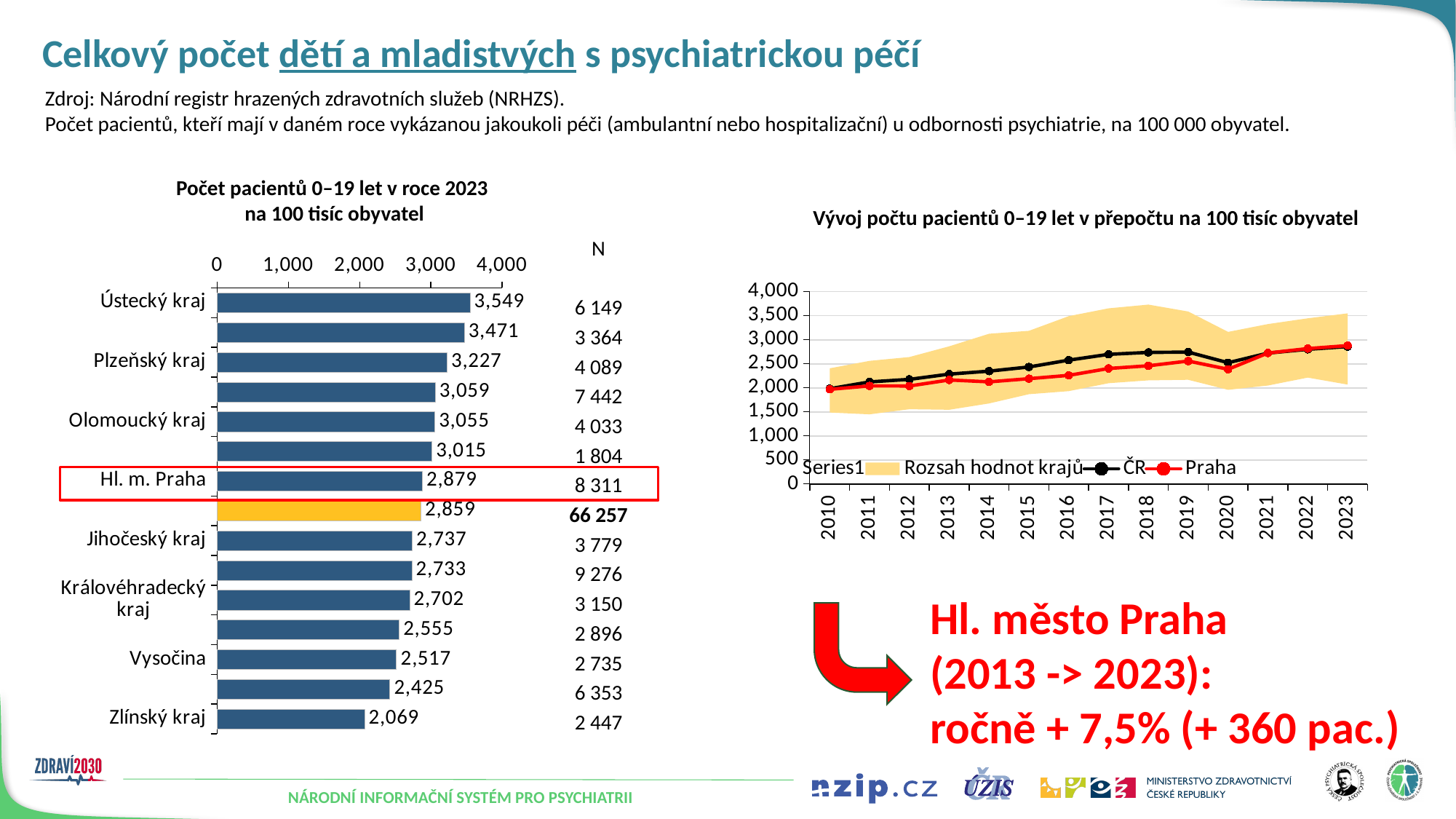
In the bar chart 'Počet pacientů 0–19 let v roce 2023 na 100 tisíc obyvatel', which region has the lowest value? Zlínský kraj In the line chart 'Vývoj počtu pacientů 0–19 let v přepočtu na 100 tisíc obyvatel', how many entries does the legend list? 4 In the bar chart 'Počet pacientů 0–19 let v roce 2023 na 100 tisíc obyvatel', what is the value for Ústecký kraj? 3,549 In the line chart 'Vývoj počtu pacientů 0–19 let v přepočtu na 100 tisíc obyvatel', do the values for Praha generally rise or fall from 2010 to 2023? rise In the bar chart 'Počet pacientů 0–19 let v roce 2023 na 100 tisíc obyvatel', how many bars are plotted? 15 In the bar chart 'Počet pacientů 0–19 let v roce 2023 na 100 tisíc obyvatel', what is the difference between the values for Ústecký kraj and Zlínský kraj? 1,480 In the bar chart 'Počet pacientů 0–19 let v roce 2023 na 100 tisíc obyvatel', what is the value for Zlínský kraj? 2,069 In the bar chart 'Počet pacientů 0–19 let v roce 2023 na 100 tisíc obyvatel', which region has the highest value? Ústecký kraj In the bar chart 'Počet pacientů 0–19 let v roce 2023 na 100 tisíc obyvatel', what is the value for Hl. m. Praha? 2,879 In the line chart 'Vývoj počtu pacientů 0–19 let v přepočtu na 100 tisíc obyvatel', is the value for ČR in 2023 greater or less than 2,500? greater What kind of chart is 'Počet pacientů 0–19 let v roce 2023 na 100 tisíc obyvatel'? Bar chart In the bar chart 'Počet pacientů 0–19 let v roce 2023 na 100 tisíc obyvatel', which is larger, the value for Plzeňský kraj or the value for Vysočina? Plzeňský kraj